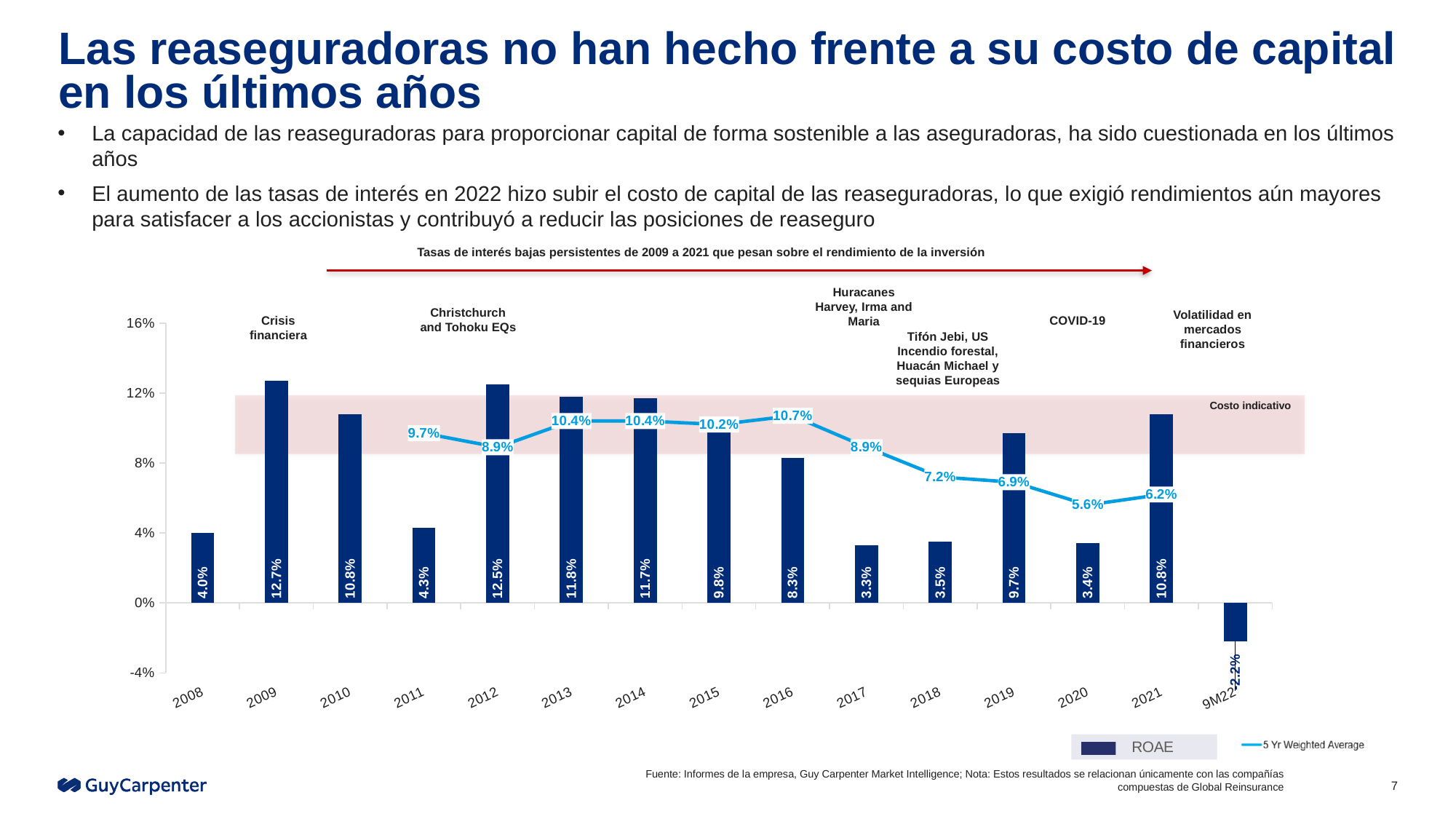
Which year has the highest ROAE bar? 2009 What is the ROAE value for 2009? 12.7% What is the ROAE value for 9M22? -2.2% How many categories are shown on the x axis? 15 What is the difference between the ROAE values for 2012 and 2011? 8.2% What are the two series named in the legend? ROAE and 5 Yr Weighted Average How many series does the legend list? 2 What is the 5 Yr Weighted Average value for 2018? 7.2% Does the 5 Yr Weighted Average line rise or fall from 2016 to 2020? Fall What kind of chart is shown on the slide? A bar chart combined with a line chart Which category has the lowest ROAE bar? 9M22 Which is larger, the ROAE for 2017 or the ROAE for 2018? 2018